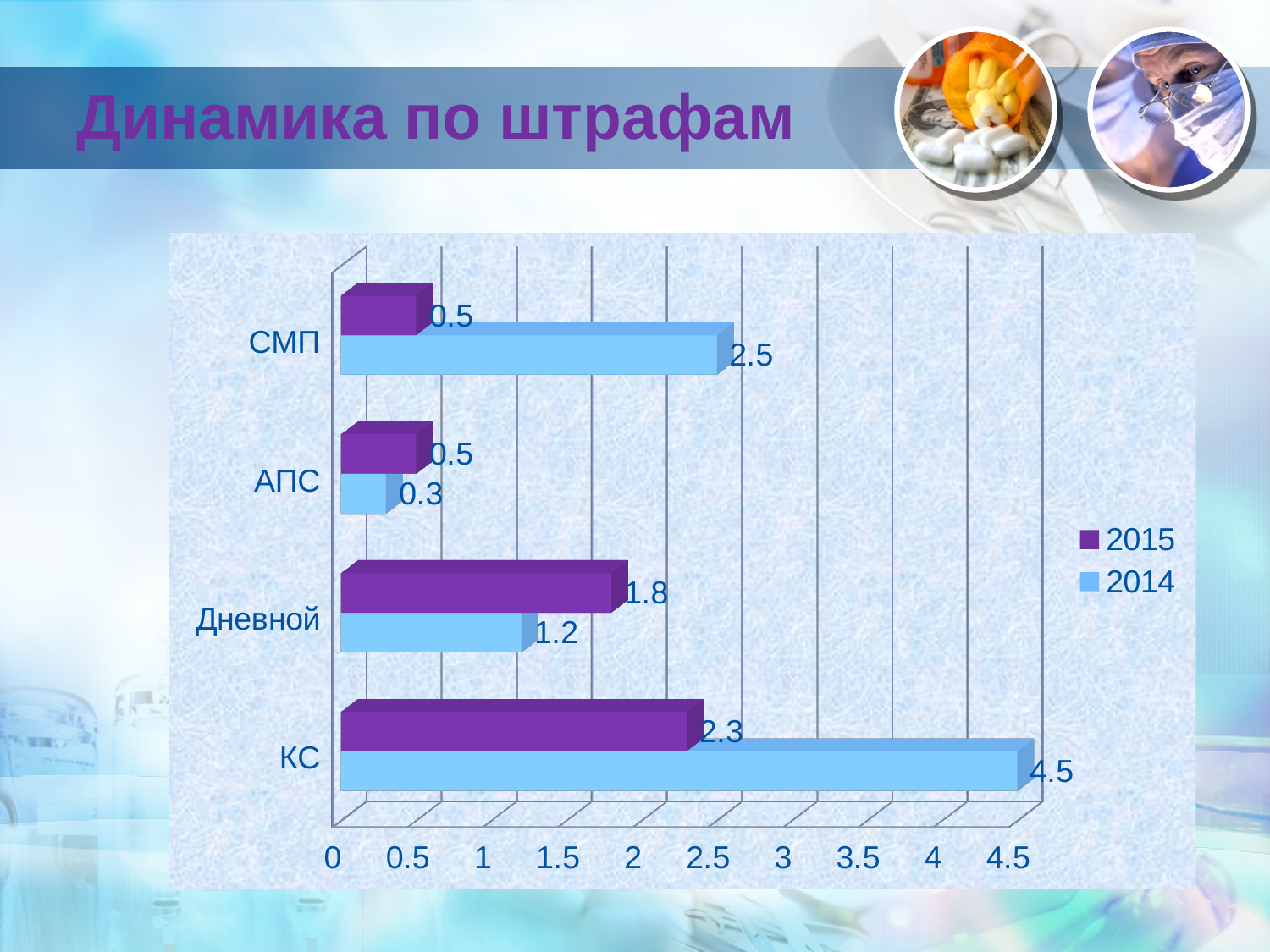
Which is larger for Дневной: the 2015 value or the 2014 value? 2015 What is the difference between the 2014 and 2015 values for КС? 2.2 What is the value for Дневной in the 2015 series? 1.8 What is the title of the slide? Динамика по штрафам What is the value for АПС in the 2014 series? 0.3 What is the value for КС in the 2014 series? 4.5 How many categories are shown on the chart? 4 Which category has the highest value in the 2015 series? КС What kind of chart is shown on the slide? Bar chart What is the value for СМП in the 2014 series? 2.5 How many series does the legend list? 2 Which category has the lowest value in the 2014 series? АПС